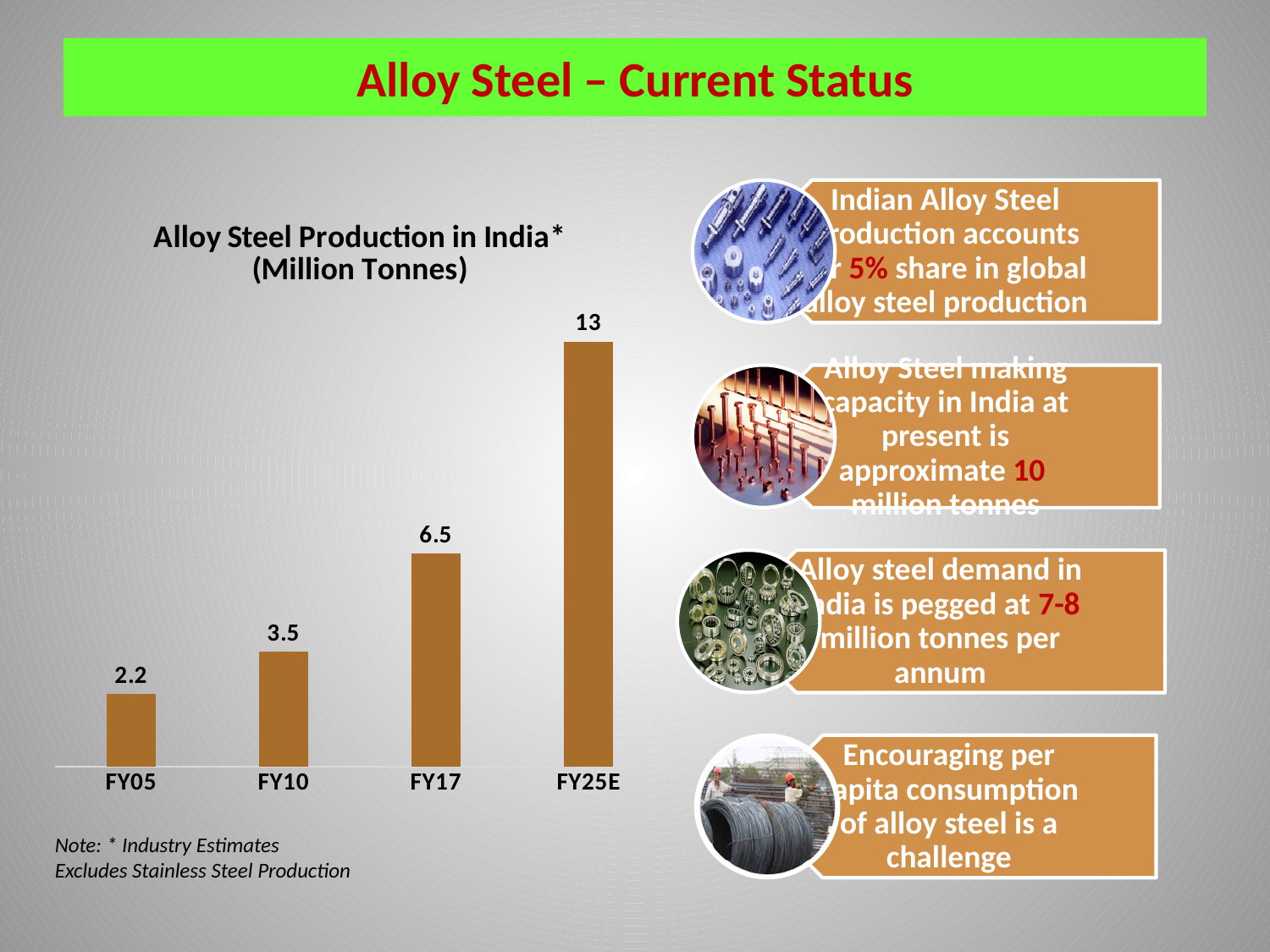
What type of chart is used to show alloy steel production in India? Bar chart What is the alloy steel production value for FY25E? 13 Which is larger, the production value for FY17 or for FY10? FY17 What is the alloy steel production value for FY05? 2.2 How many years (categories) are shown in the chart? 4 What is the difference between the FY10 and FY05 production values? 1.3 What is the alloy steel production value for FY10? 3.5 Which year has the lowest alloy steel production value? FY05 What is the difference between the FY25E and FY17 production values? 6.5 Which year has the highest alloy steel production value? FY25E Do the production values rise or fall from FY05 to FY25E? Rise What is the alloy steel production value for FY17? 6.5